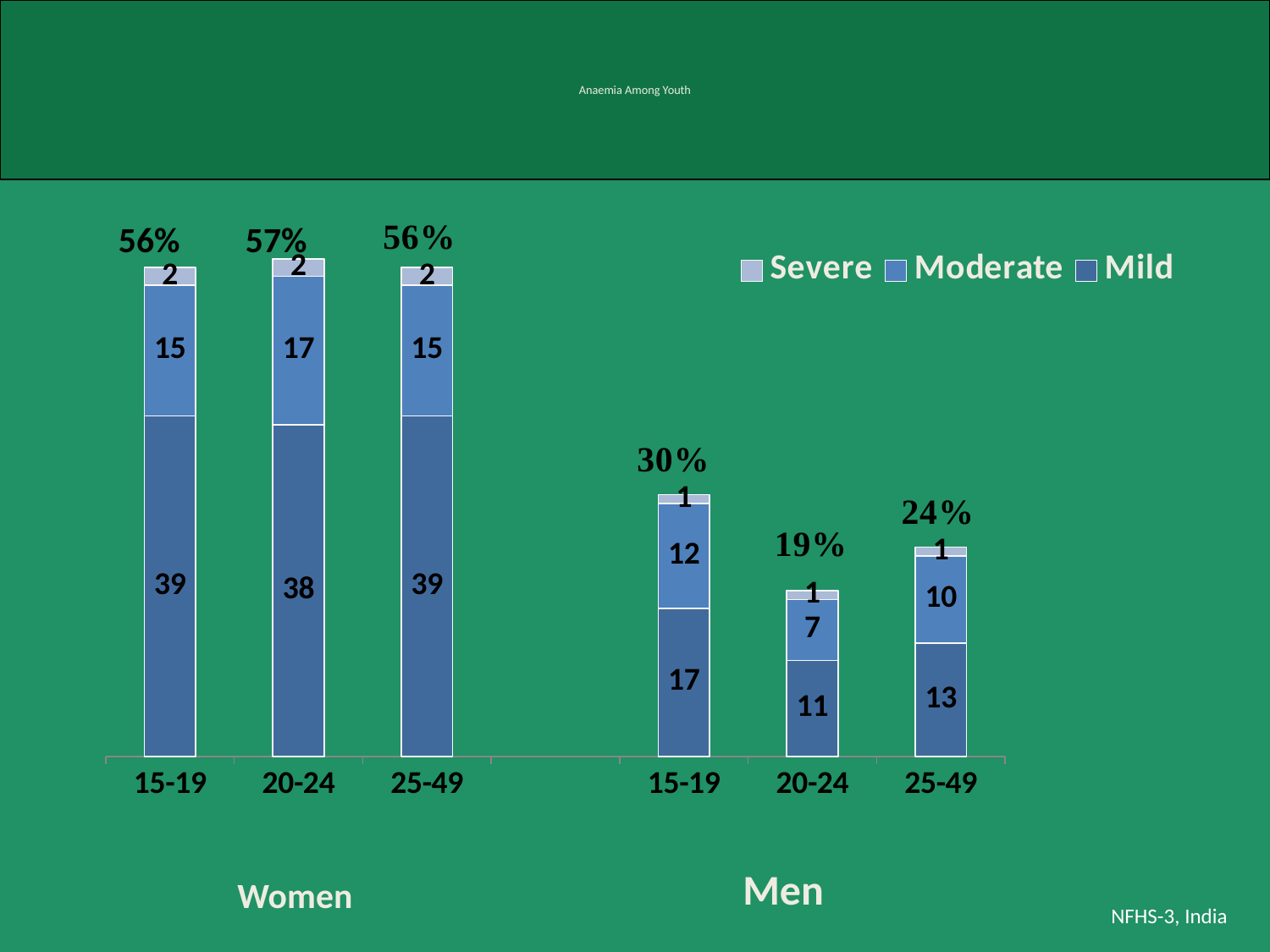
What kind of chart is shown on the slide? stacked bar chart How many age-group bars are plotted in total across women and men? 6 How many series does the legend list? 3 What is the difference between the Mild value for women aged 25-49 and the Mild value for men aged 25-49? 26 What is the Moderate value for men aged 25-49? 10 What is the Moderate value for women aged 20-24? 17 What is the total anaemia percentage shown above the bar for men aged 15-19? 30% What is the Mild value for men aged 20-24? 11 Which age group among women has the highest total anaemia percentage? 20-24 Which age group among men has the lowest total anaemia percentage? 20-24 What is the Mild value for women aged 15-19? 39 Which is larger: the Moderate value for men aged 15-19 or the Moderate value for men aged 20-24? men aged 15-19